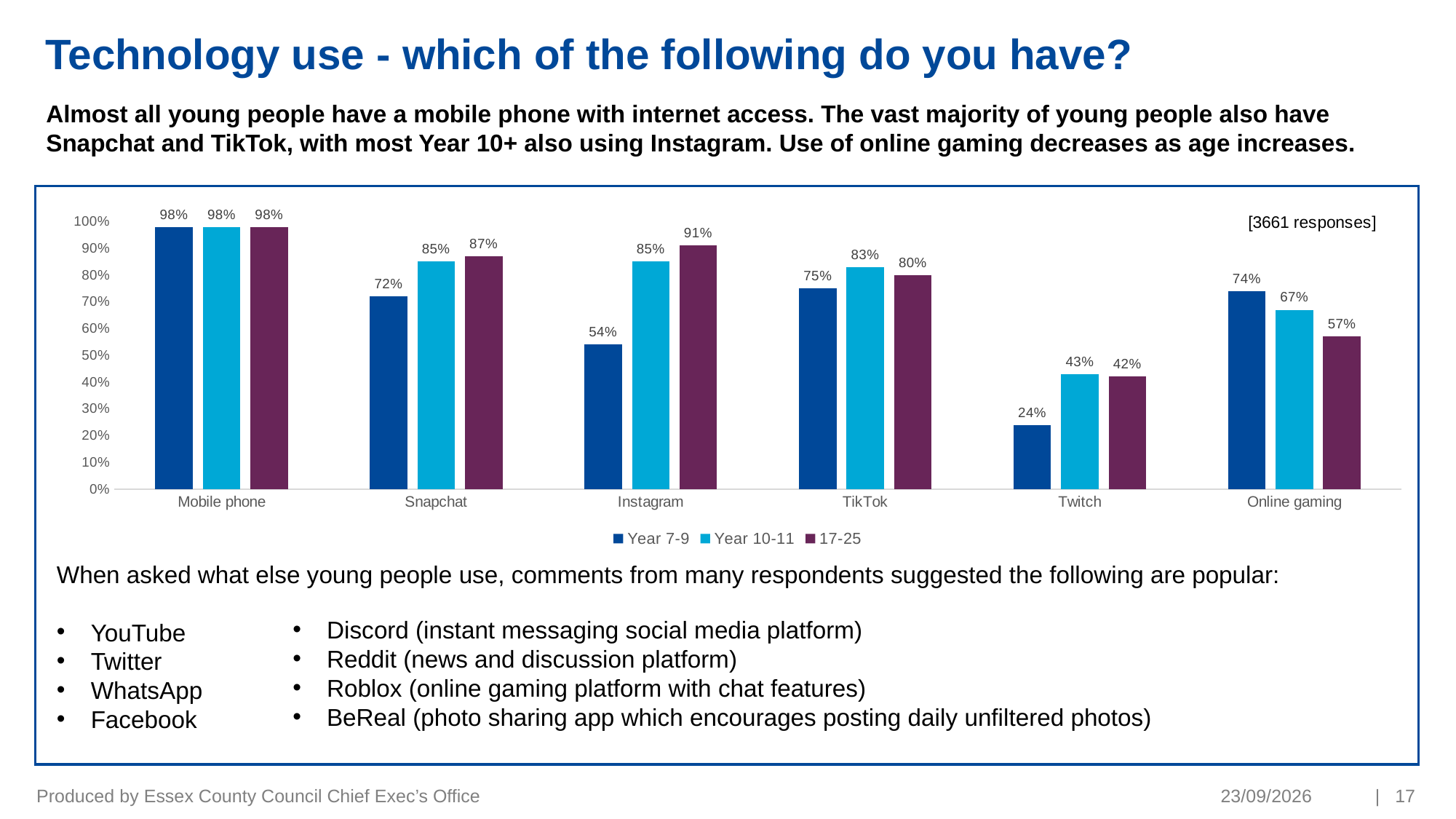
What percentage of Year 10-11 respondents have Twitch? 43% What kind of chart is shown on the slide? Bar chart Do the values for Online gaming rise or fall from Year 7-9 to 17-25? Fall How many responses does the chart note it is based on? 3661 responses What is the value for 17-25 for Online gaming? 57% What percentage of Year 7-9 respondents have Instagram? 54% Which category has the highest value for 17-25? Mobile phone Which is larger for TikTok: the Year 10-11 value or the 17-25 value? Year 10-11 How many categories are shown on the x axis? 6 How many series does the legend list? 3 What is the difference between the 17-25 and Year 7-9 values for Instagram? 37 percentage points Which category has the lowest value for Year 7-9? Twitch